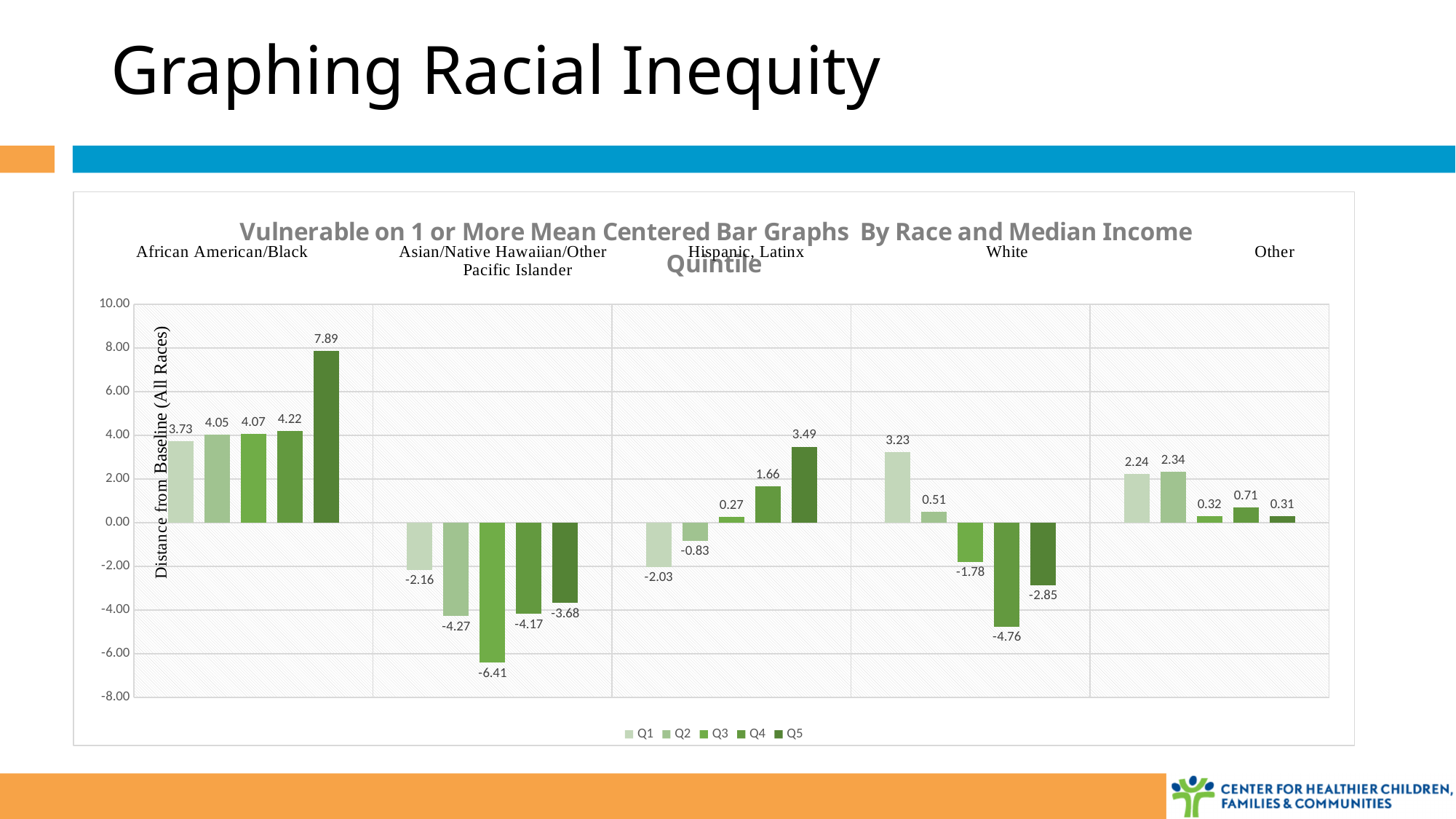
What is the Q4 value for White? -4.76 What is the difference between the Q5 and Q1 values for African American/Black? 4.16 Do the values for Hispanic, Latinx rise or fall from Q1 to Q5? Rise Which race group has the highest bar on the chart? African American/Black What kind of chart is shown on the slide? Bar chart What is the Q2 value for Hispanic, Latinx? -0.83 Which is larger, the Q1 value for White or the Q1 value for Other? Q1 value for White Which quintile has the lowest value for Asian/Native Hawaiian/Other Pacific Islander? Q3 Is the Q5 value for Hispanic, Latinx greater or less than 2.00? greater What is the Q5 value for African American/Black? 7.89 How many series does the legend list? 5 What is the Q3 value for Asian/Native Hawaiian/Other Pacific Islander? -6.41